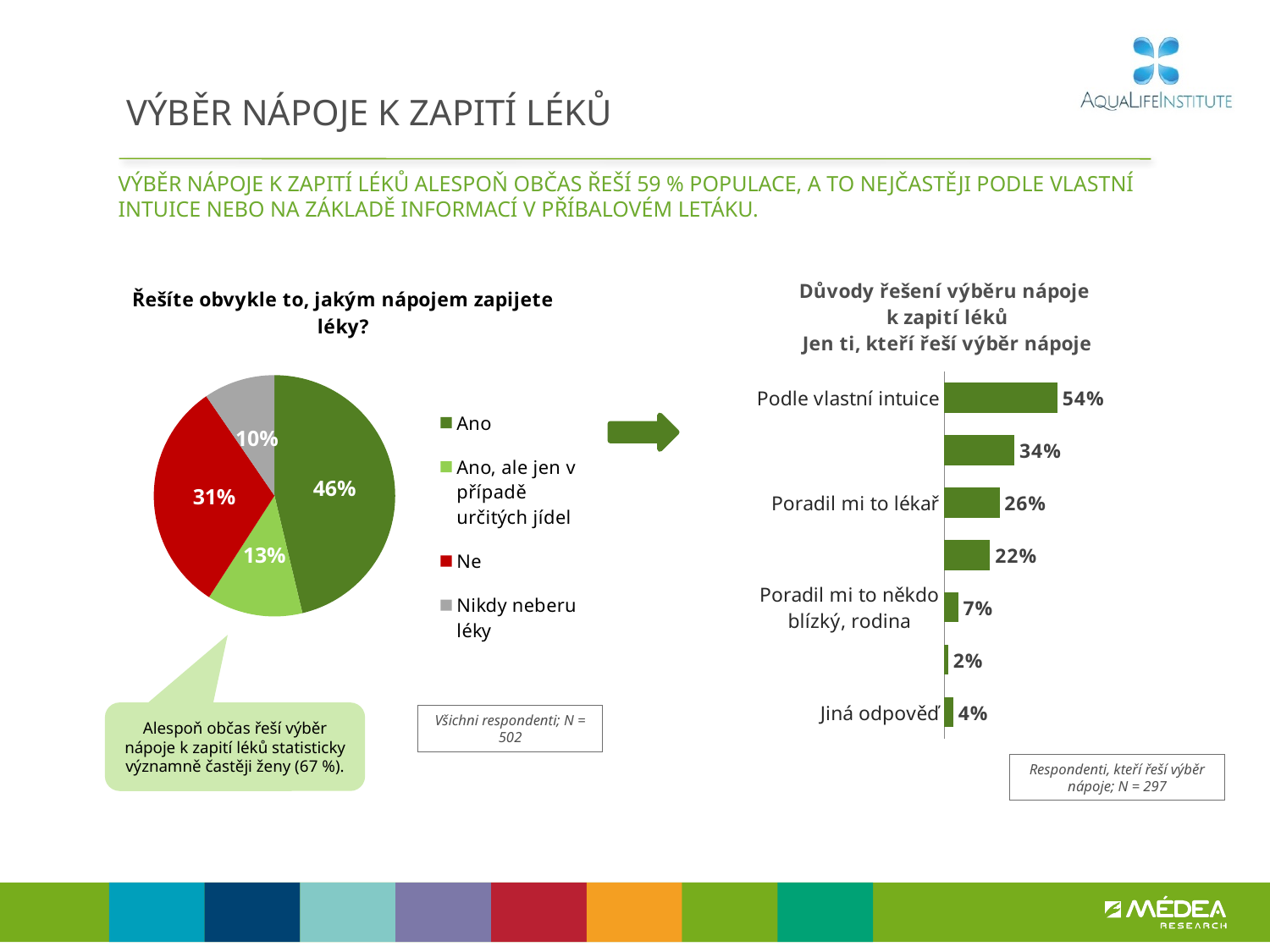
In the pie chart "Řešíte obvykle to, jakým nápojem zapijete léky?", how many entries does the legend list? 4 In the bar chart "Důvody řešení výběru nápoje k zapití léků", which is larger: "Poradil mi to někdo blízký, rodina" or "Jiná odpověď"? Poradil mi to někdo blízký, rodina In the pie chart "Řešíte obvykle to, jakým nápojem zapijete léky?", what share does "Ne" have? 31% In the pie chart "Řešíte obvykle to, jakým nápojem zapijete léky?", what is the difference between "Ano" and "Ano, ale jen v případě určitých jídel"? 33% In the bar chart "Důvody řešení výběru nápoje k zapití léků", what is the value for "Poradil mi to lékař"? 26% In the pie chart "Řešíte obvykle to, jakým nápojem zapijete léky?", which category has the largest slice? Ano In the pie chart "Řešíte obvykle to, jakým nápojem zapijete léky?", which category has the smallest slice? Nikdy neberu léky In the pie chart "Řešíte obvykle to, jakým nápojem zapijete léky?", what percentage is shown for "Ano"? 46% What type of chart is "Důvody řešení výběru nápoje k zapití léků"? Bar chart In the bar chart "Důvody řešení výběru nápoje k zapití léků", how many bars are plotted? 7 In the bar chart "Důvody řešení výběru nápoje k zapití léků", what is the value for "Podle vlastní intuice"? 54% What type of chart is the chart on the left of the slide? Pie chart